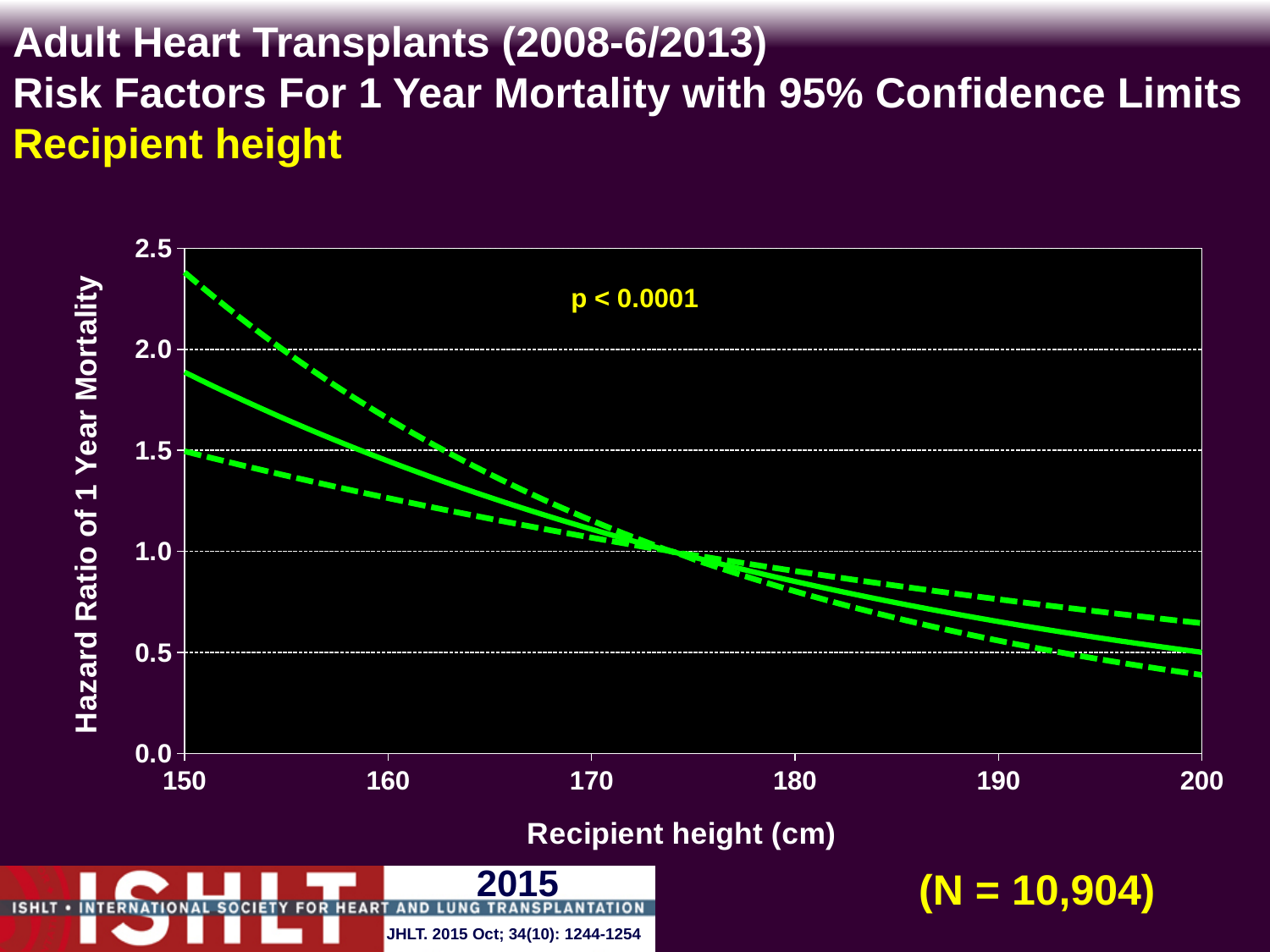
Is the upper confidence limit (upper dashed line) at a recipient height of 150 cm greater or less than 2.0? greater Is the hazard ratio on the solid line at a recipient height of 160 cm greater or less than 1.0? greater What is the p-value shown on the chart? p < 0.0001 Is the hazard ratio on the solid line at a recipient height of 180 cm greater or less than 1.0? less What kind of chart is shown on the slide? Line chart What is the label of the x axis? Recipient height (cm) What is the highest value shown on the y axis? 2.5 Does the hazard ratio of 1 year mortality rise or fall as recipient height increases from 150 cm to 200 cm? Fall What is the sample size (N) shown on the slide? N = 10,904 How many lines are plotted on the chart? 3